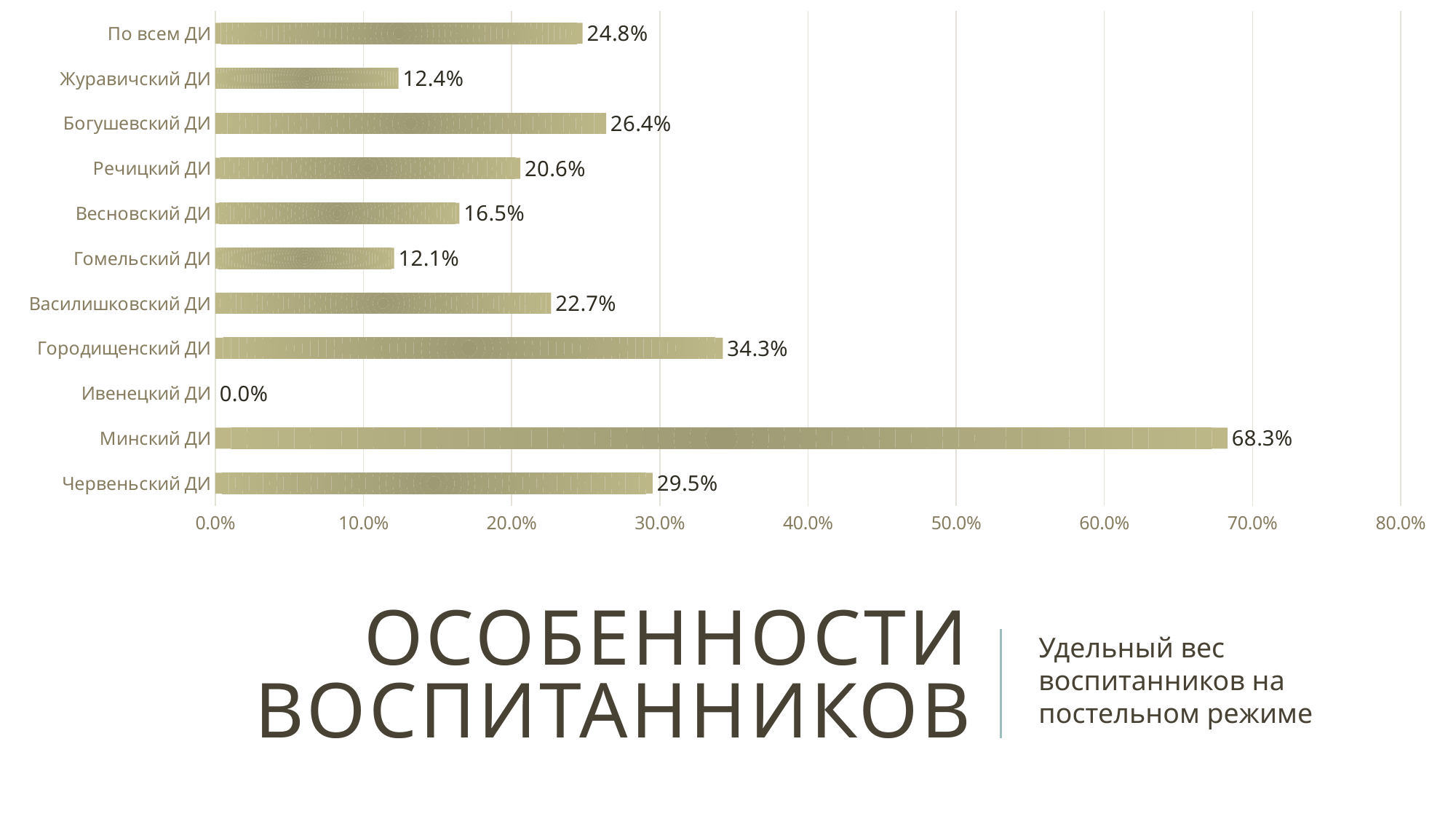
Is the value for Городищенский ДИ greater or less than 30.0%? greater What is the maximum value shown on the x axis? 80.0% What is the difference between the values for Журавичский ДИ and Гомельский ДИ? 0.3% What is the value for По всем ДИ? 24.8% How many categories are shown on the chart? 11 Which category has the lowest value? Ивенецкий ДИ What is the value for Городищенский ДИ? 34.3% Which category has the highest value? Минский ДИ Which is larger, the value for Богушевский ДИ or the value for Речицкий ДИ? Богушевский ДИ What kind of chart is shown on the slide? bar chart What is the value for Минский ДИ? 68.3% What is the difference between the values for Минский ДИ and Червеньский ДИ? 38.8%